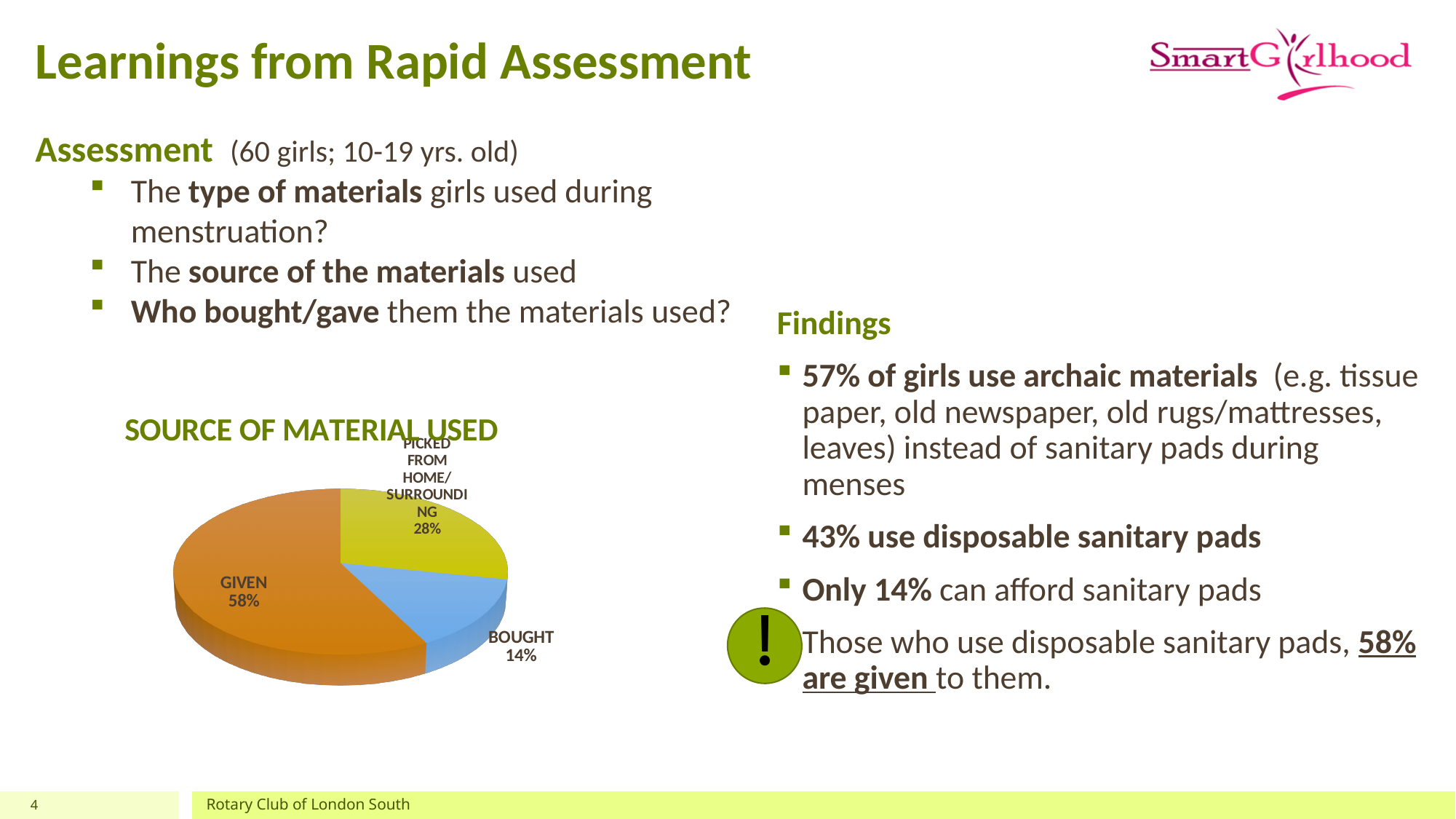
Which category has the smallest slice of the pie? BOUGHT What share of the pie does PICKED FROM HOME/SURROUNDING represent? 28% Which is larger, the share for GIVEN or the share for PICKED FROM HOME/SURROUNDING? GIVEN Which category has the largest slice of the pie? GIVEN What share of the pie does GIVEN represent? 58% What kind of chart is shown on the slide? Pie chart What colour is the GIVEN slice of the pie? Orange What share of the pie does BOUGHT represent? 14% What is the difference in percentage points between GIVEN and BOUGHT? 44 What is the difference in percentage points between PICKED FROM HOME/SURROUNDING and BOUGHT? 14 What is the title of the chart? SOURCE OF MATERIAL USED How many categories are shown in the pie chart? 3